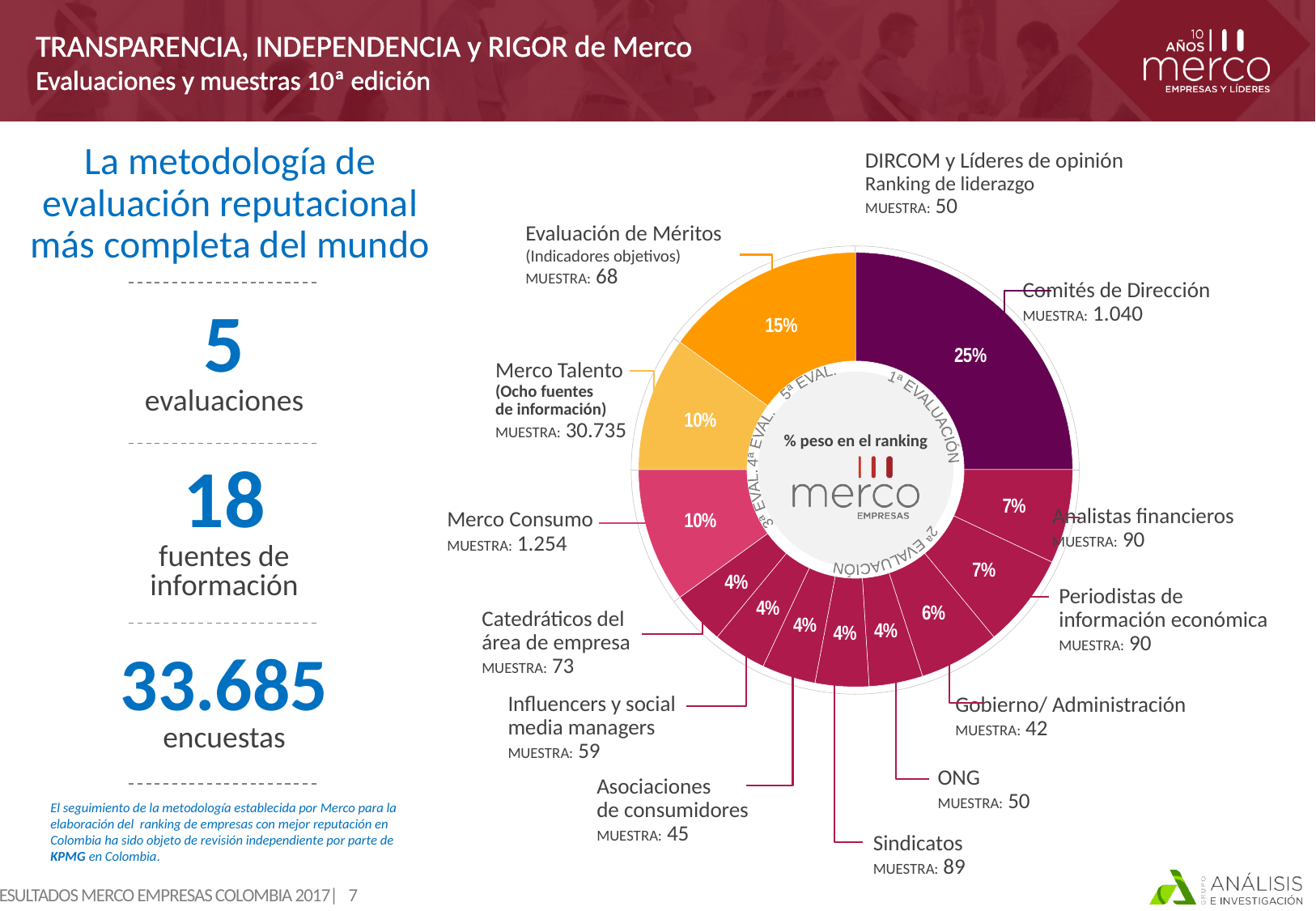
Which has a larger ranking weight, Analistas financieros or Gobierno/ Administración? Analistas financieros Which category has the largest share of the ranking weight? Comités de Dirección How many slices does the donut chart have? 12 What percentage weight in the ranking does Gobierno/ Administración have? 6% What text is shown in the centre of the donut chart above the Merco logo? % peso en el ranking What percentage weight in the ranking does Comités de Dirección have? 25% What percentage weight in the ranking does Evaluación de Méritos have? 15% What is the combined ranking weight of Merco Consumo and Merco Talento? 20% What percentage weight in the ranking does Merco Talento have? 10% What type of chart is shown on the slide? pie chart (donut) What is the sample size (muestra) shown for Merco Talento? 30.735 What is the difference in ranking weight between Comités de Dirección and Evaluación de Méritos? 10%